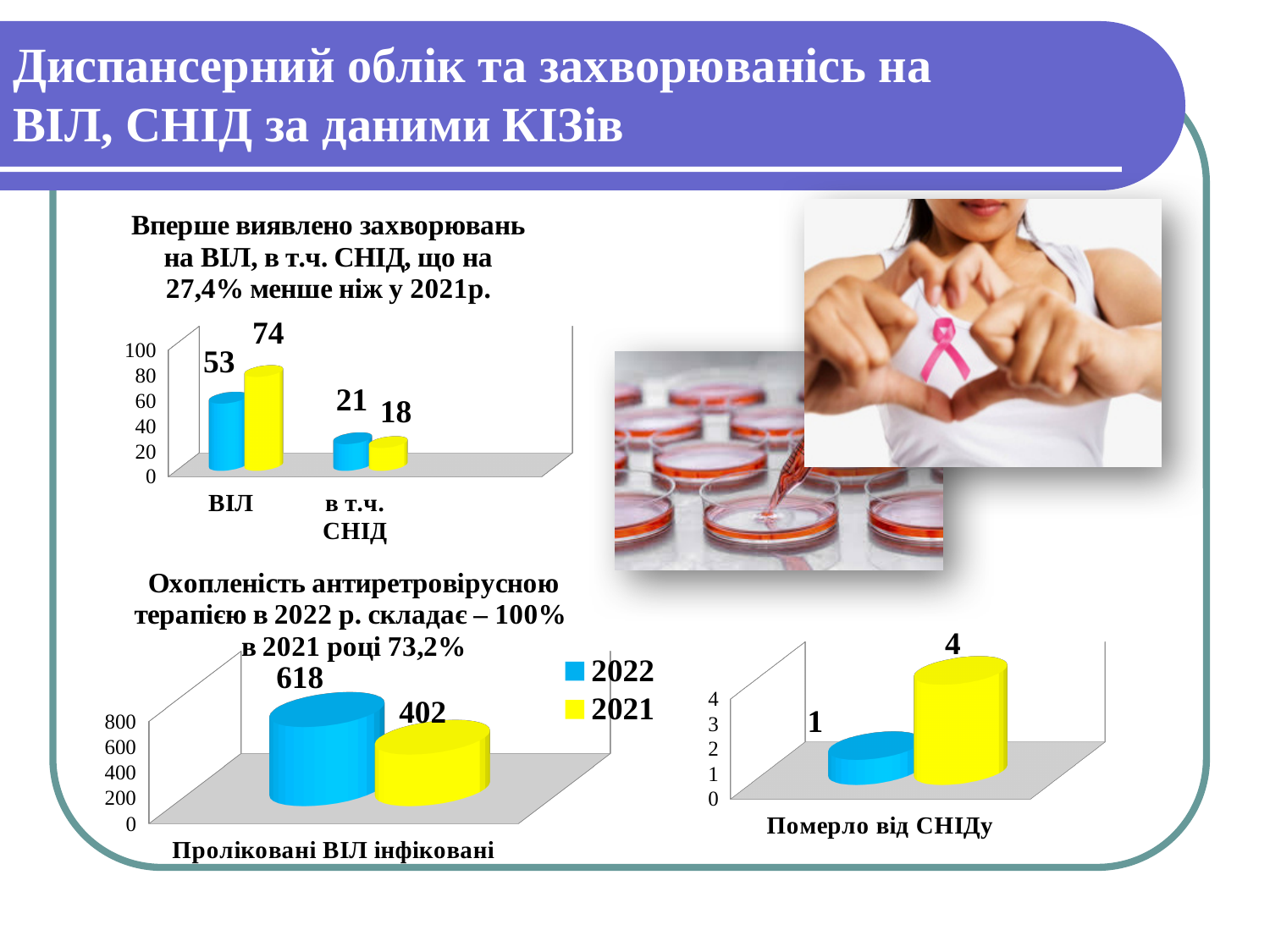
In the top-left chart (first detected HIV cases), how many categories are shown on the x axis? 2 In the top-left chart (first detected HIV cases), what is the value of the yellow bar for ВІЛ? 74 How many entries does the legend on the slide list? 2 In the top-left chart (first detected HIV cases), what is the value of the blue bar for в т.ч. СНІД? 21 In the bottom-right chart titled 'Померло від СНІДу', which bar is higher, the blue one or the yellow one? the yellow one In the bottom-left chart titled 'Проліковані ВІЛ інфіковані', what is the difference between the 2022 and 2021 values? 216 In the bottom-left chart titled 'Проліковані ВІЛ інфіковані', what is the value of the yellow (2021) bar? 402 In the top-left chart (first detected HIV cases), what is the value of the blue bar for ВІЛ? 53 In the bottom-left chart titled 'Проліковані ВІЛ інфіковані', what is the value of the blue (2022) bar? 618 In the bottom-right chart titled 'Померло від СНІДу', what is the value of the yellow (2021) bar? 4 In the top-left chart (first detected HIV cases), what is the difference between the yellow and blue bars for ВІЛ? 21 In the top-left chart (first detected HIV cases), which bar is larger for в т.ч. СНІД, the blue one or the yellow one? the blue one